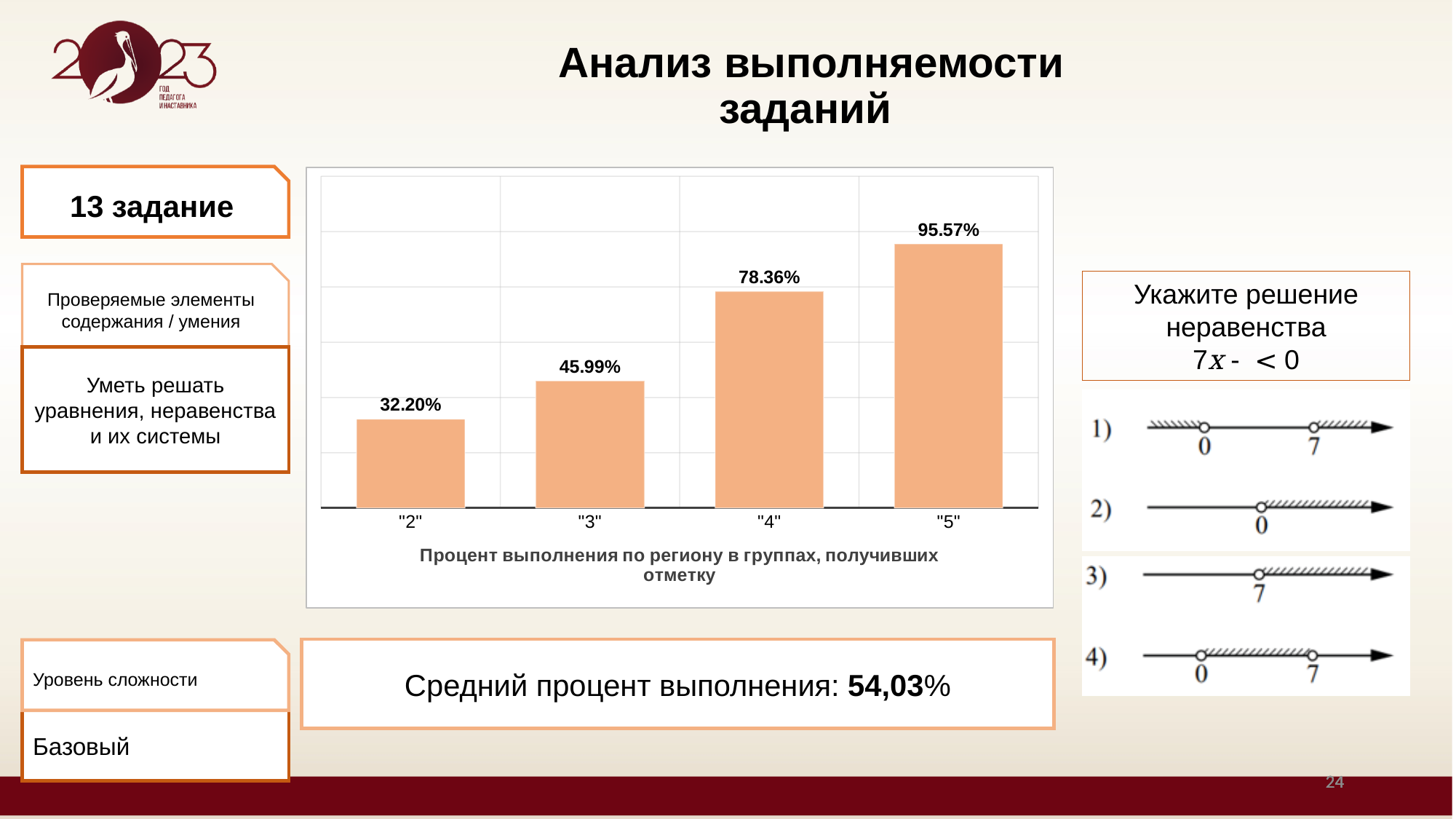
Which group has the highest completion percentage? "5" What is the value for the "3" group? 45.99% What is the value for the "4" group? 78.36% How many groups (bars) are shown in the chart? 4 Which group has the lowest completion percentage? "2" What is the difference between the values for the "3" and "2" groups? 13.79% What type of chart is shown on the slide? Bar chart Which is larger, the value for the "3" group or the "4" group? "4" What is the difference between the values for the "5" and "4" groups? 17.21% What is the value for the "5" group? 95.57% Do the values rise or fall from the "2" group to the "5" group? Rise What is the value for the "2" group? 32.20%